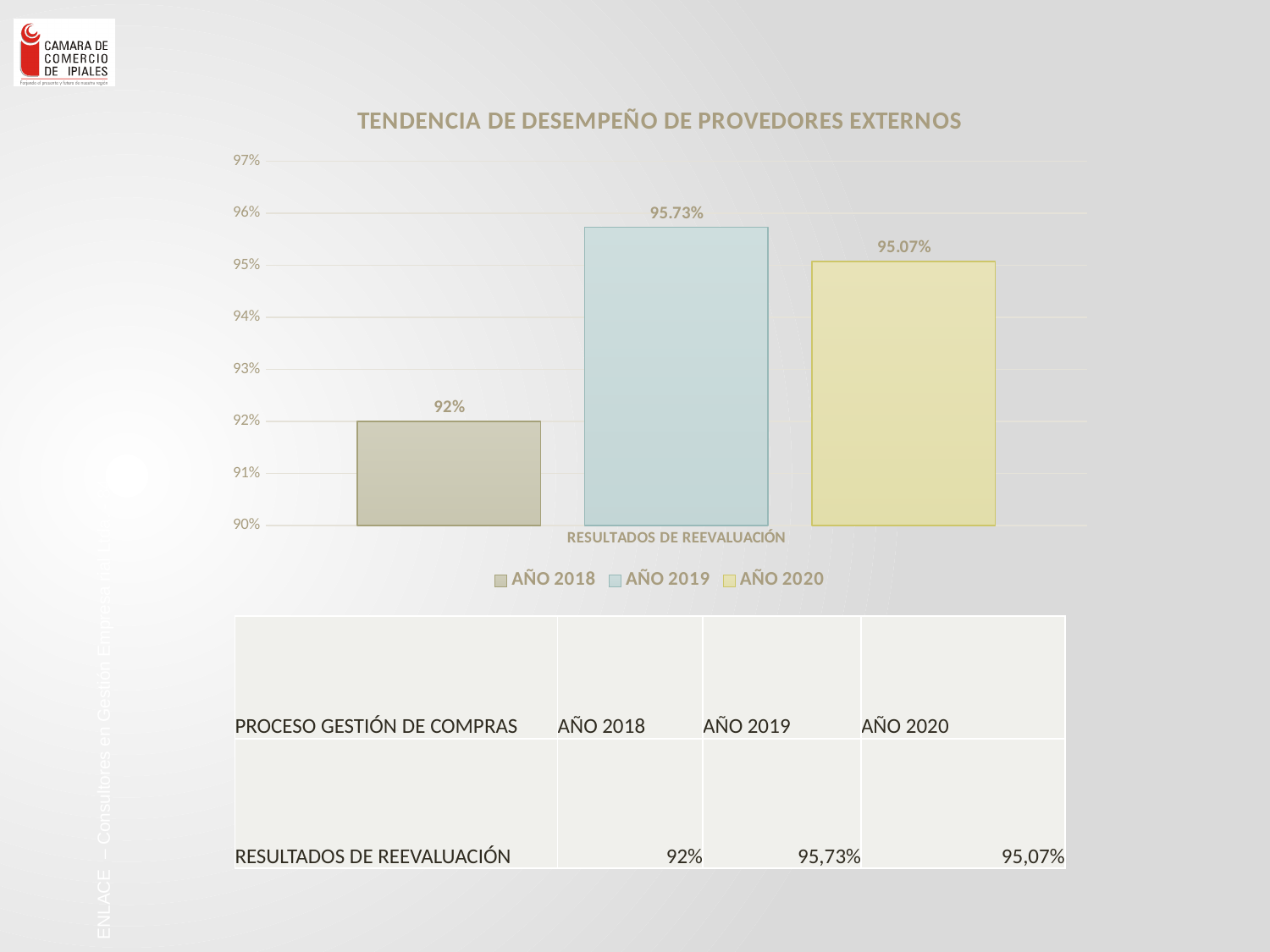
What is the difference between the values for AÑO 2019 and AÑO 2018? 3.73% Which is larger, the value for AÑO 2018 or the value for AÑO 2020? AÑO 2020 What is the value for AÑO 2019 in the chart? 95.73% What is the value for AÑO 2020 in the chart? 95.07% Is the value for AÑO 2020 greater or less than 94%? greater How many series does the legend list? 3 Which series has the highest value in the chart? AÑO 2019 What is the title of the chart? TENDENCIA DE DESEMPEÑO DE PROVEDORES EXTERNOS What is the difference between the values for AÑO 2019 and AÑO 2020? 0.66% What is the value for AÑO 2018 in the chart? 92% What kind of chart is shown on the slide? bar chart Which series has the lowest value in the chart? AÑO 2018